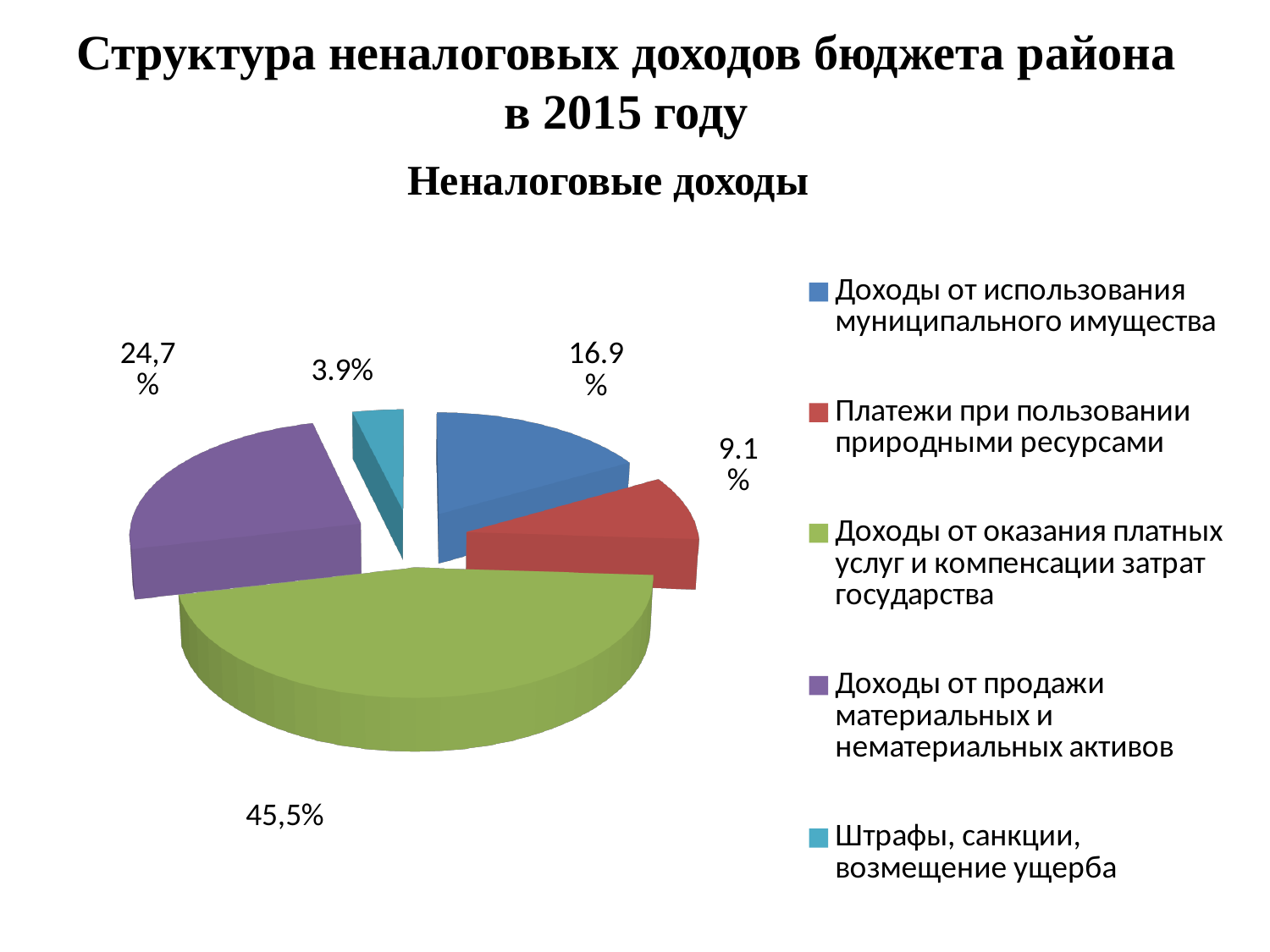
Which category has the largest slice of the pie? Доходы от оказания платных услуг и компенсации затрат государства What is the title of the chart? Неналоговые доходы What share of the pie does 'Доходы от оказания платных услуг и компенсации затрат государства' have? 45,5% What is the value shown for 'Доходы от продажи материальных и нематериальных активов'? 24,7% Which category has the smallest slice of the pie? Штрафы, санкции, возмещение ущерба What type of chart is shown on the slide? Pie chart How many slices does the pie chart have? 5 What is the value shown for 'Платежи при пользовании природными ресурсами'? 9.1% What is the value shown for 'Штрафы, санкции, возмещение ущерба'? 3.9% What is the value shown for 'Доходы от использования муниципального имущества'? 16.9% Which is larger: 'Доходы от использования муниципального имущества' or 'Платежи при пользовании природными ресурсами'? Доходы от использования муниципального имущества What is the difference between the shares of 'Доходы от использования муниципального имущества' and 'Платежи при пользовании природными ресурсами'? 7.8%